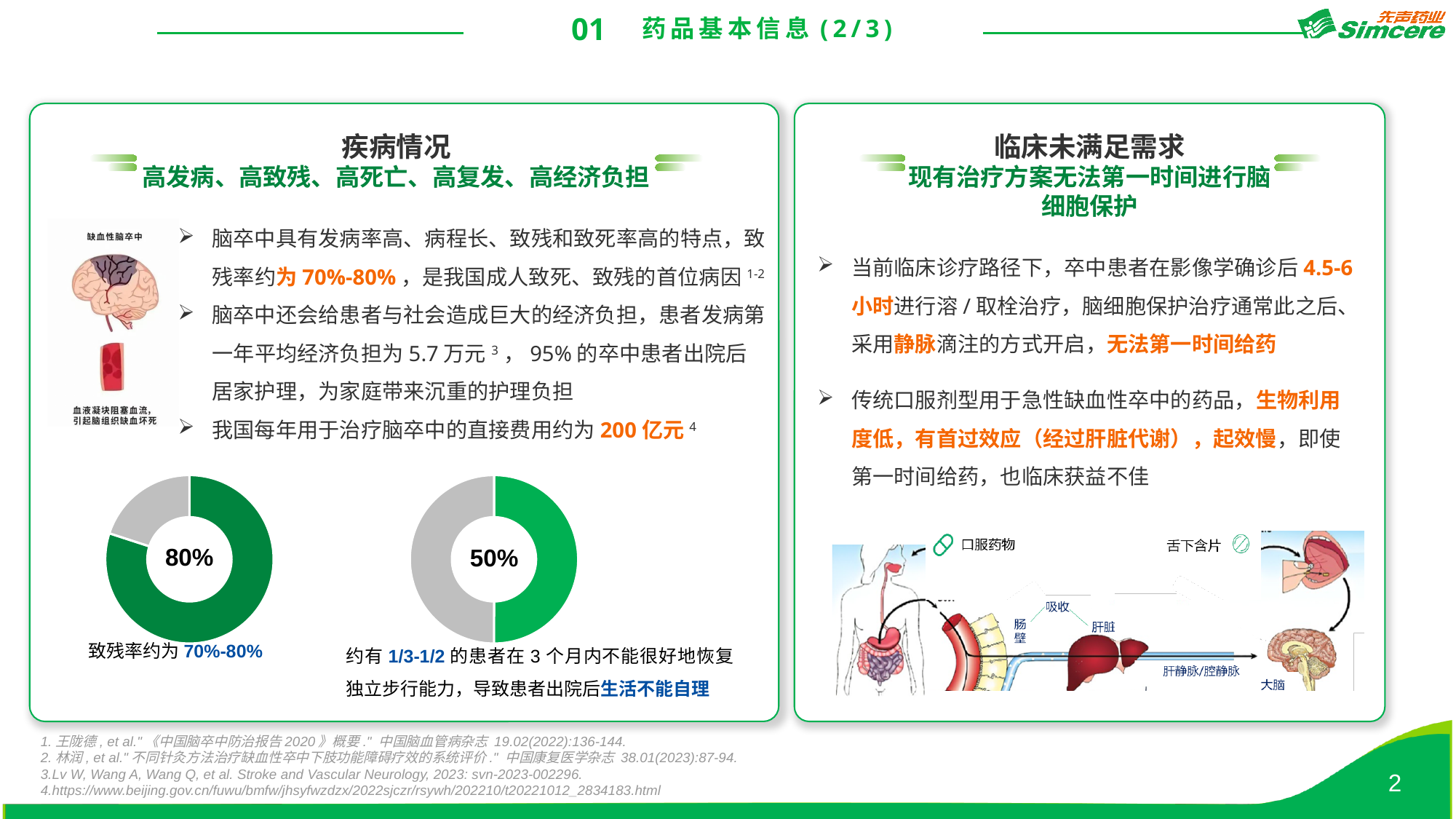
What kind of chart is the left chart labelled 80% on the slide? Donut (pie) chart In the right donut chart, what share of the ring is filled in green? 50% In the left donut chart, what share of the ring is filled in green? 80% What value is printed in the centre of the left donut chart (致残率)? 80% In the left donut chart, what share of the ring is grey? 20% What range does the caption under the left donut chart give for 致残率? 70%-80% What is the difference between the value in the left donut chart and the value in the right donut chart? 30% Which donut chart shows the larger value, the left one (致残率) or the right one (不能恢复独立步行能力)? The left one (80%) What colour is used for the highlighted (filled) portion of both donut charts? Green What value is printed in the centre of the right donut chart (患者不能很好地恢复独立步行能力)? 50% What kind of chart is the right chart labelled 50% on the slide? Donut (pie) chart How many donut charts are shown on the slide? 2